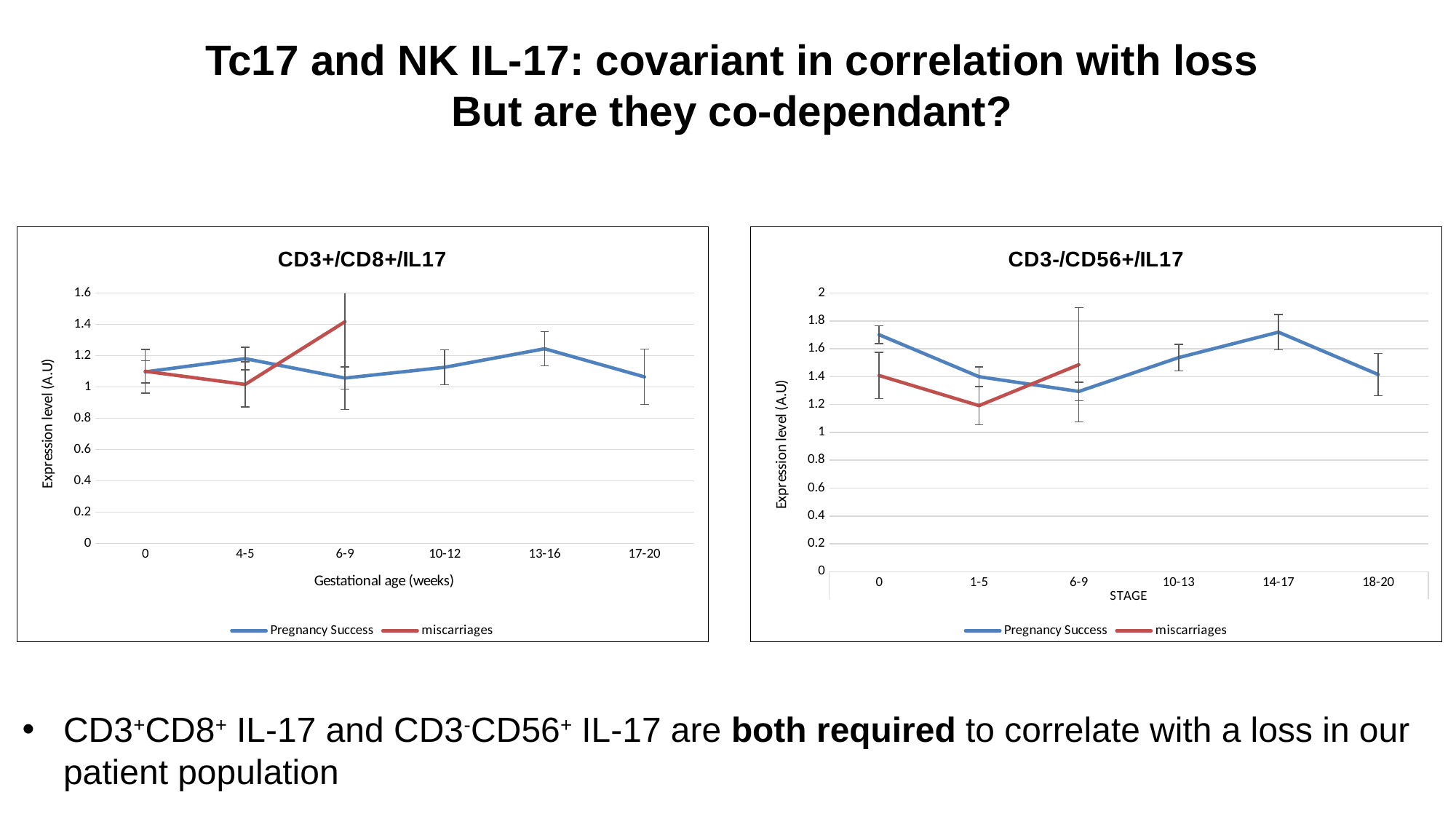
In the CD3-/CD56+/IL17 chart, does the Pregnancy Success series rise or fall from stage 0 to stage 6-9? fall How many series does the legend of the CD3-/CD56+/IL17 chart list? 2 What kind of chart is the CD3+/CD8+/IL17 chart on the left? line chart In the CD3-/CD56+/IL17 chart, at which stage does the miscarriages series reach its lowest value? 1-5 In the CD3+/CD8+/IL17 chart, at 6-9 weeks, which series has the larger value: Pregnancy Success or miscarriages? miscarriages In the CD3+/CD8+/IL17 chart, at which gestational age does the miscarriages series reach its highest value? 6-9 In the CD3+/CD8+/IL17 chart, is the miscarriages value at 6-9 weeks greater or less than 1.2? greater In the CD3-/CD56+/IL17 chart, is the Pregnancy Success value at stage 0 greater or less than 1.6? greater In the CD3-/CD56+/IL17 chart, at stage 0, which series has the larger value: Pregnancy Success or miscarriages? Pregnancy Success In the CD3-/CD56+/IL17 chart, is the miscarriages value at stage 1-5 greater or less than 1.4? less What is the x-axis label of the CD3-/CD56+/IL17 chart? STAGE How many gestational age categories are shown on the x axis of the CD3+/CD8+/IL17 chart? 6